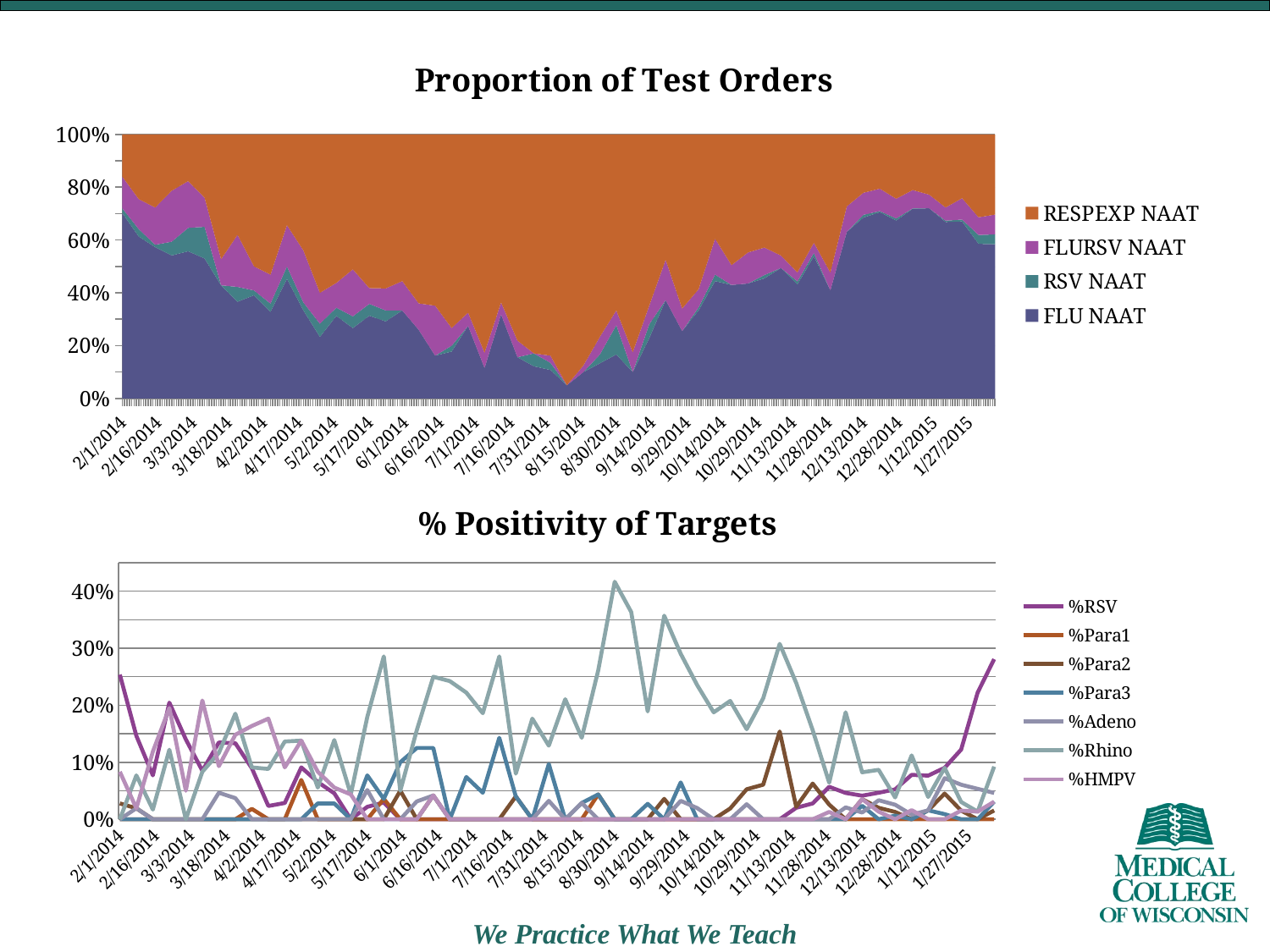
In the 'Proportion of Test Orders' chart, does the FLU NAAT share rise or fall from 2/1/2014 to 8/15/2014? fall What kind of chart is the '% Positivity of Targets' chart? line chart How many series does the legend of the '% Positivity of Targets' chart list? 7 What kind of chart is the 'Proportion of Test Orders' chart? stacked area chart How many series does the legend of the 'Proportion of Test Orders' chart list? 4 In the '% Positivity of Targets' chart, does %RSV rise or fall from 12/28/2014 to 1/27/2015? rise In the 'Proportion of Test Orders' chart, is the FLU NAAT share at 8/15/2014 greater or less than 20%? less In the 'Proportion of Test Orders' chart, is the FLU NAAT share at 2/1/2014 greater or less than 60%? greater In the '% Positivity of Targets' chart, which series reaches the highest value on the chart? %Rhino In the '% Positivity of Targets' chart, which series is listed last in the legend? %HMPV In the 'Proportion of Test Orders' chart, which series is shown in orange? RESPEXP NAAT In the '% Positivity of Targets' chart, is the peak value of %Rhino near 8/30/2014 greater or less than 40%? greater